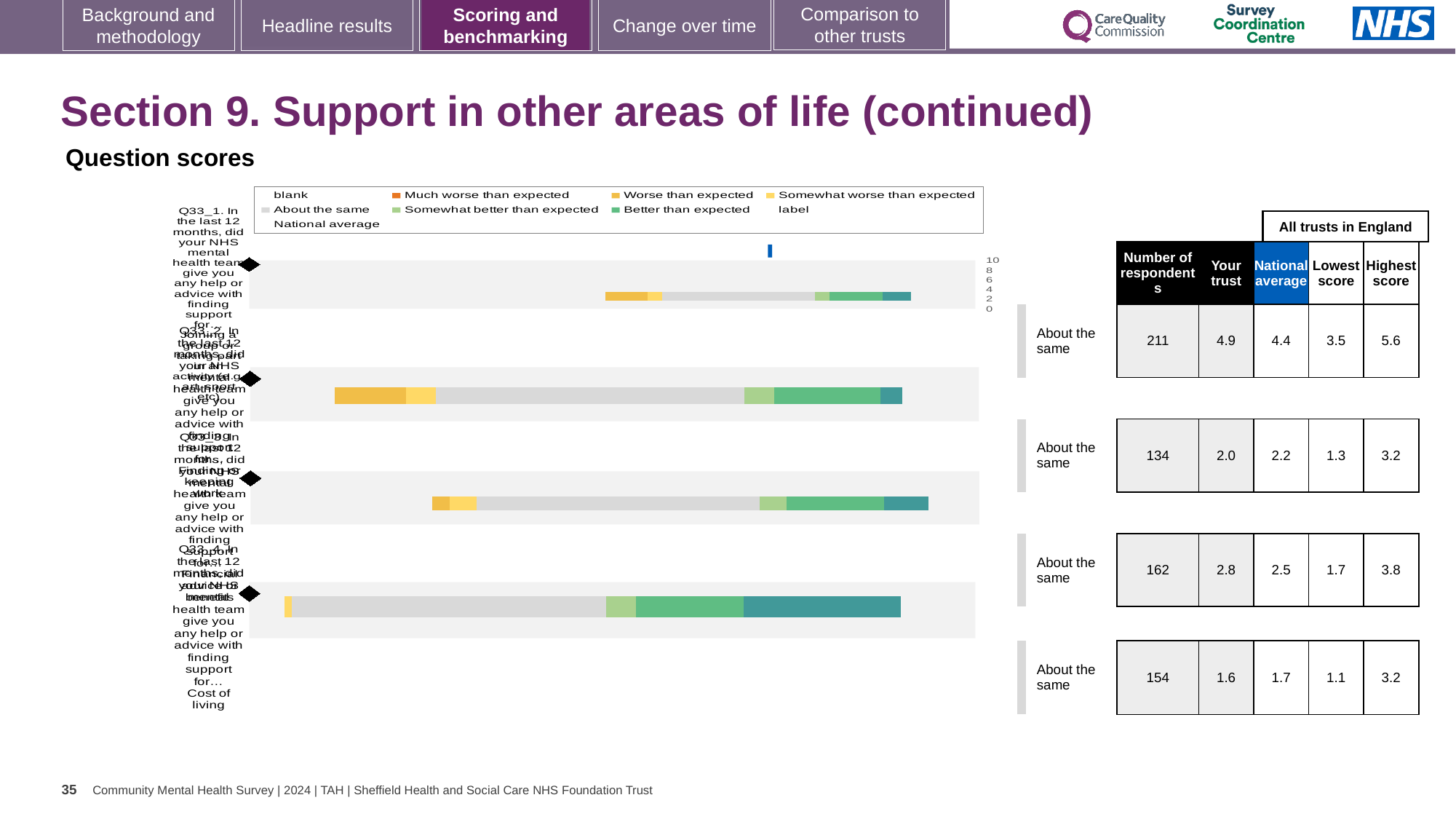
Is the 'Better than expected' segment larger for Q33_4 or for Q33_1? Q33_4 In the table beside the chart, what is the 'Your trust' score for the first question (Q33_1)? 4.9 How many question bars are plotted in the chart? 4 In the table beside the chart, what is the number of respondents for the second question (Q33_2)? 134 In the table beside the chart, what is the difference between 'Your trust' and 'National average' for the third question (Q33_3)? 0.3 How many entries does the chart legend list? 9 In the table beside the chart, what is the highest score for the fourth question (Q33_4)? 3.2 What kind of chart is shown under 'Question scores'? bar chart Which colour represents 'Much worse than expected' in the chart legend? orange Which legend entry is shown in light grey in the chart? About the same